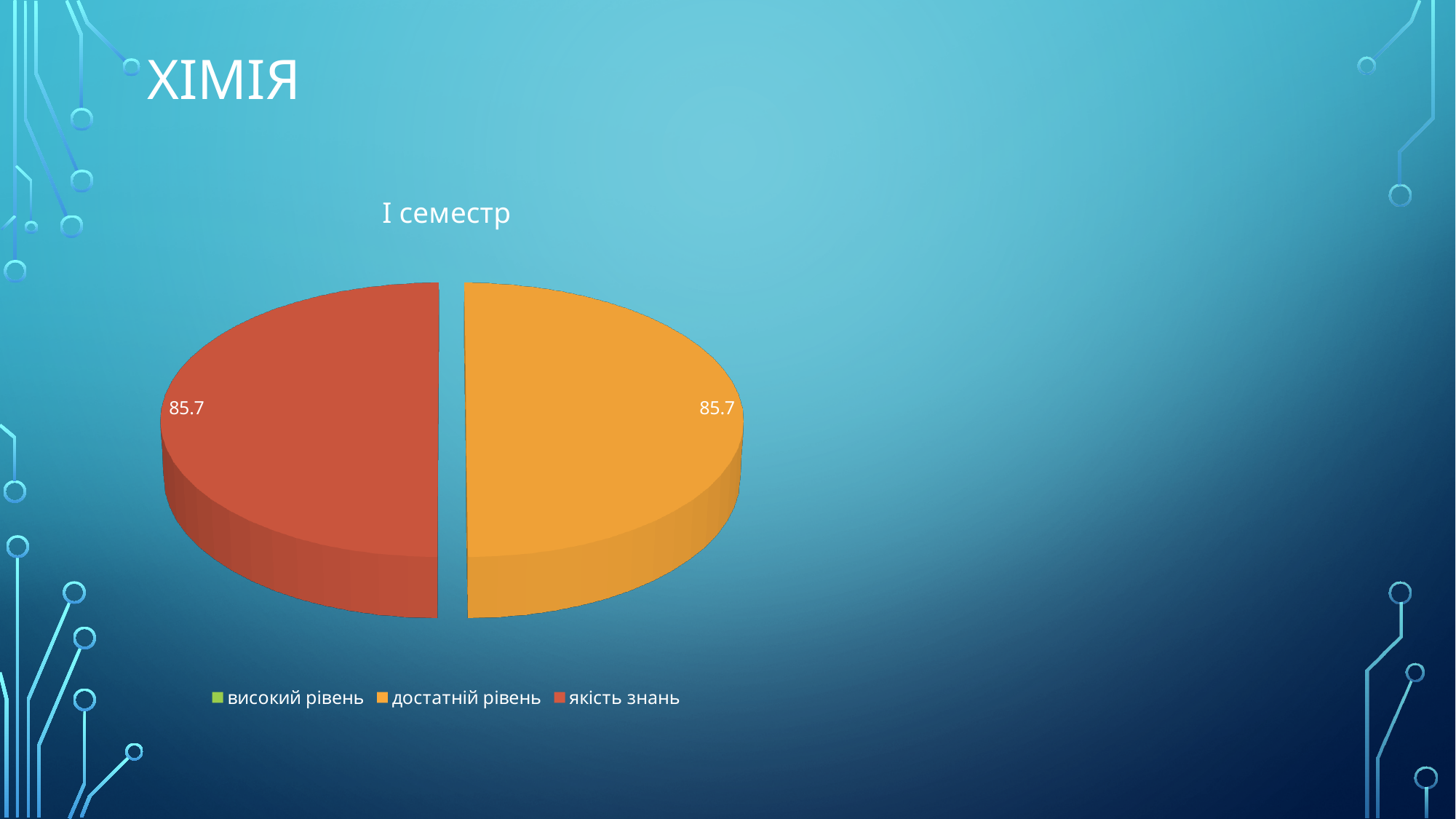
Is the value for достатній рівень equal to the value for якість знань? yes How many entries does the legend of the pie chart list? 3 What is the value shown for якість знань in the pie chart? 85.7 What is the title of the pie chart? І семестр How many slices are visible in the pie chart? 2 What kind of chart is shown on the slide? pie chart What is the value shown for достатній рівень in the pie chart? 85.7 Which colour represents якість знань in the pie chart? red